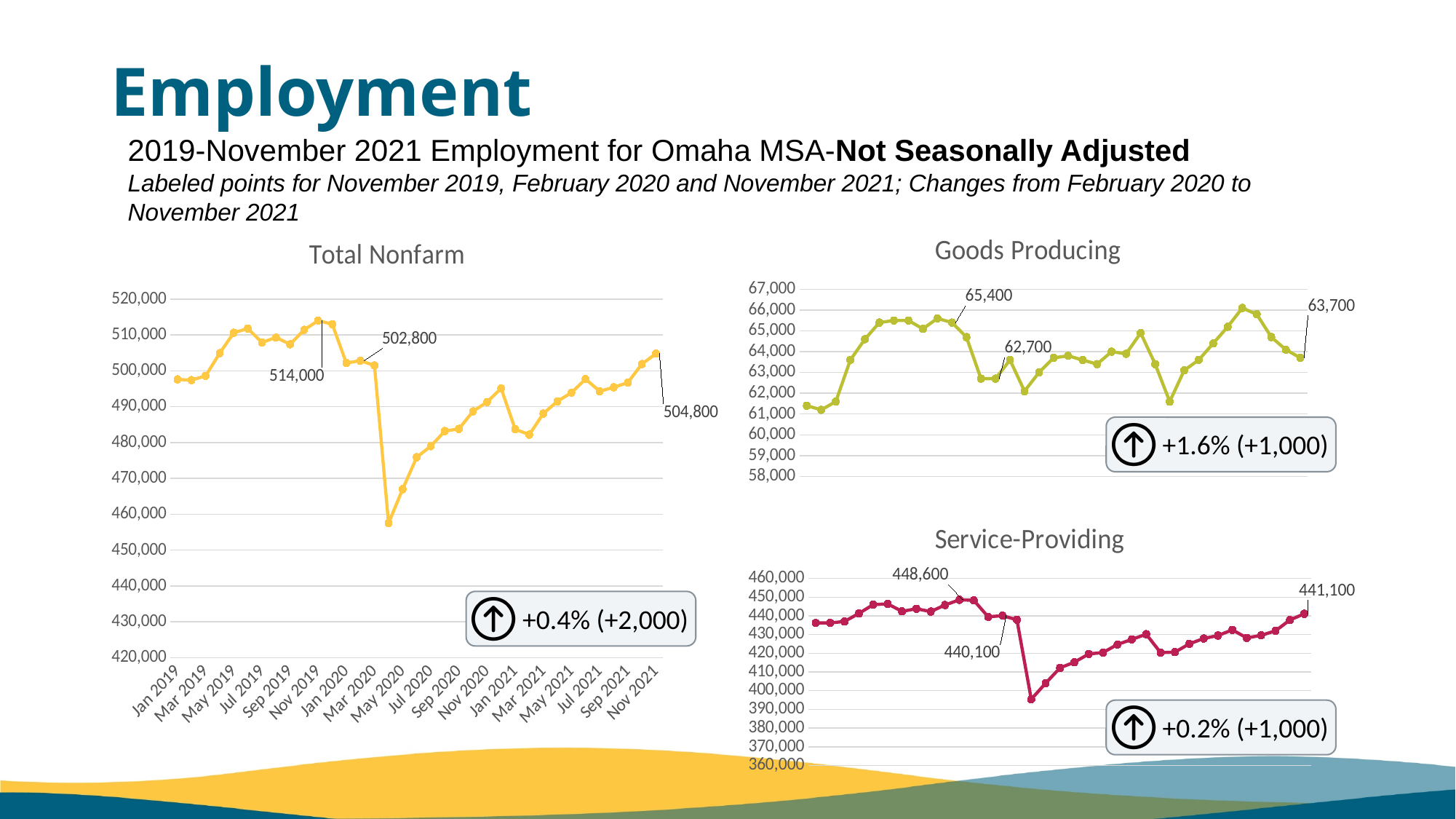
In the Total Nonfarm chart, what is the labeled value for November 2021? 504,800 In the Total Nonfarm chart, what is the labeled value for February 2020? 502,800 In the Service-Providing chart, what is the difference between the November 2019 value (448,600) and the November 2021 value (441,100)? 7,500 What kind of chart is the Goods Producing chart? Line chart In the Goods Producing chart, what is the difference between the November 2019 value (65,400) and the February 2020 value (62,700)? 2,700 In the Goods Producing chart, what is the labeled value for November 2021? 63,700 In the Total Nonfarm chart, which labeled point is higher: November 2019 or November 2021? November 2019 In the Total Nonfarm chart, is the value for May 2020 greater or less than 460,000? greater In the Total Nonfarm chart, what is the labeled value for November 2019? 514,000 In the Service-Providing chart, what is the labeled value for February 2020? 440,100 What percentage change from February 2020 to November 2021 is shown in the Goods Producing chart's callout? +1.6% (+1,000) In the Service-Providing chart, is the lowest point in 2020 greater or less than 400,000? less